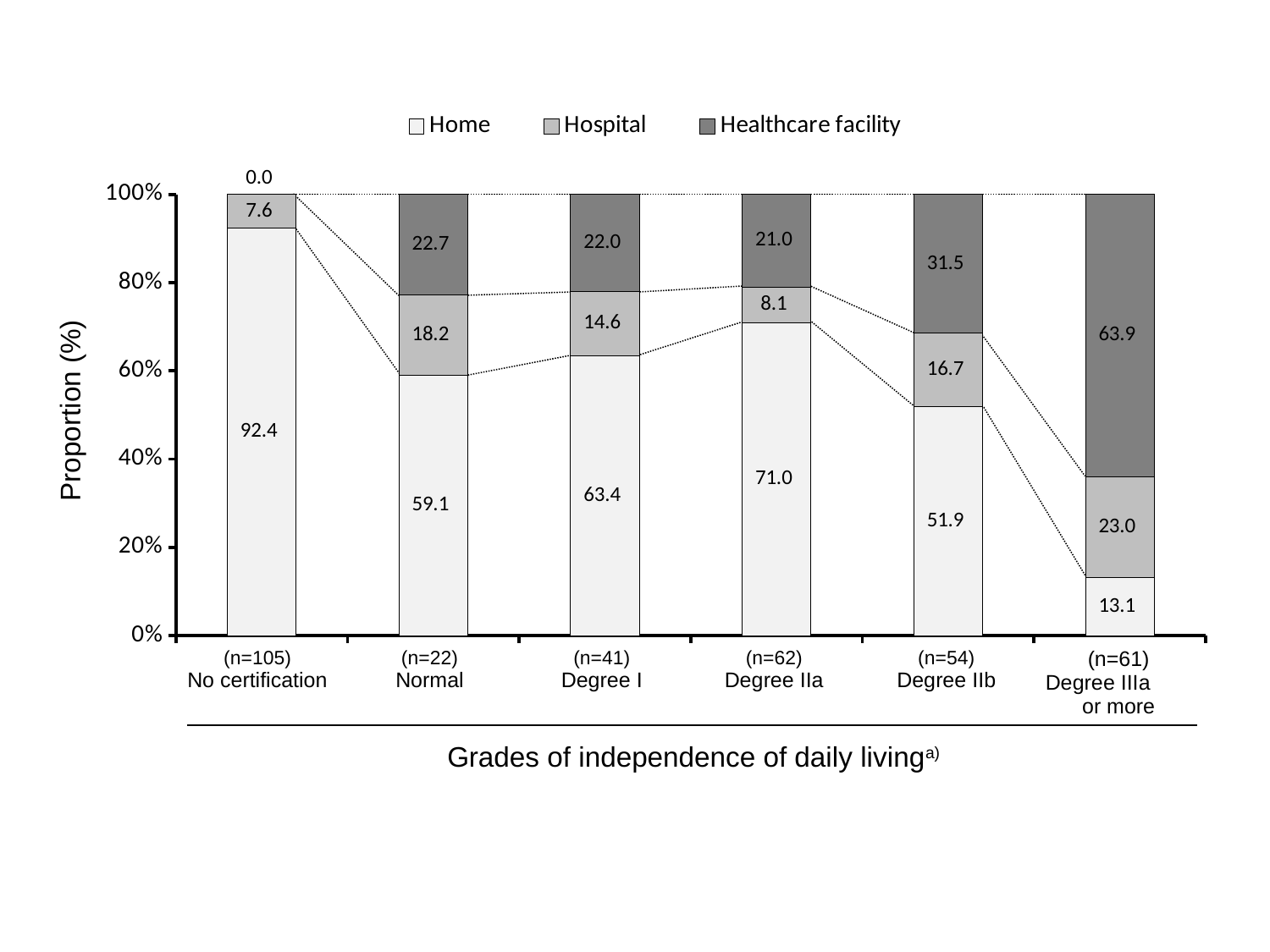
What is the Home value for Degree IIa? 71.0 How many series does the legend list? 3 What is the difference between the Home values for Degree IIb and Degree IIIa or more? 38.8 What is the x-axis title? Grades of independence of daily living What is the Healthcare facility value for No certification? 0.0 What is the Healthcare facility value for Degree IIIa or more? 63.9 What is the Hospital value for Normal? 18.2 How many categories are shown on the x axis? 6 Which category has the lowest Hospital value? No certification Which is larger, the Healthcare facility value for Degree IIb or for Degree I? Degree IIb Which category has the highest Home value? No certification What kind of chart is this? Stacked bar chart